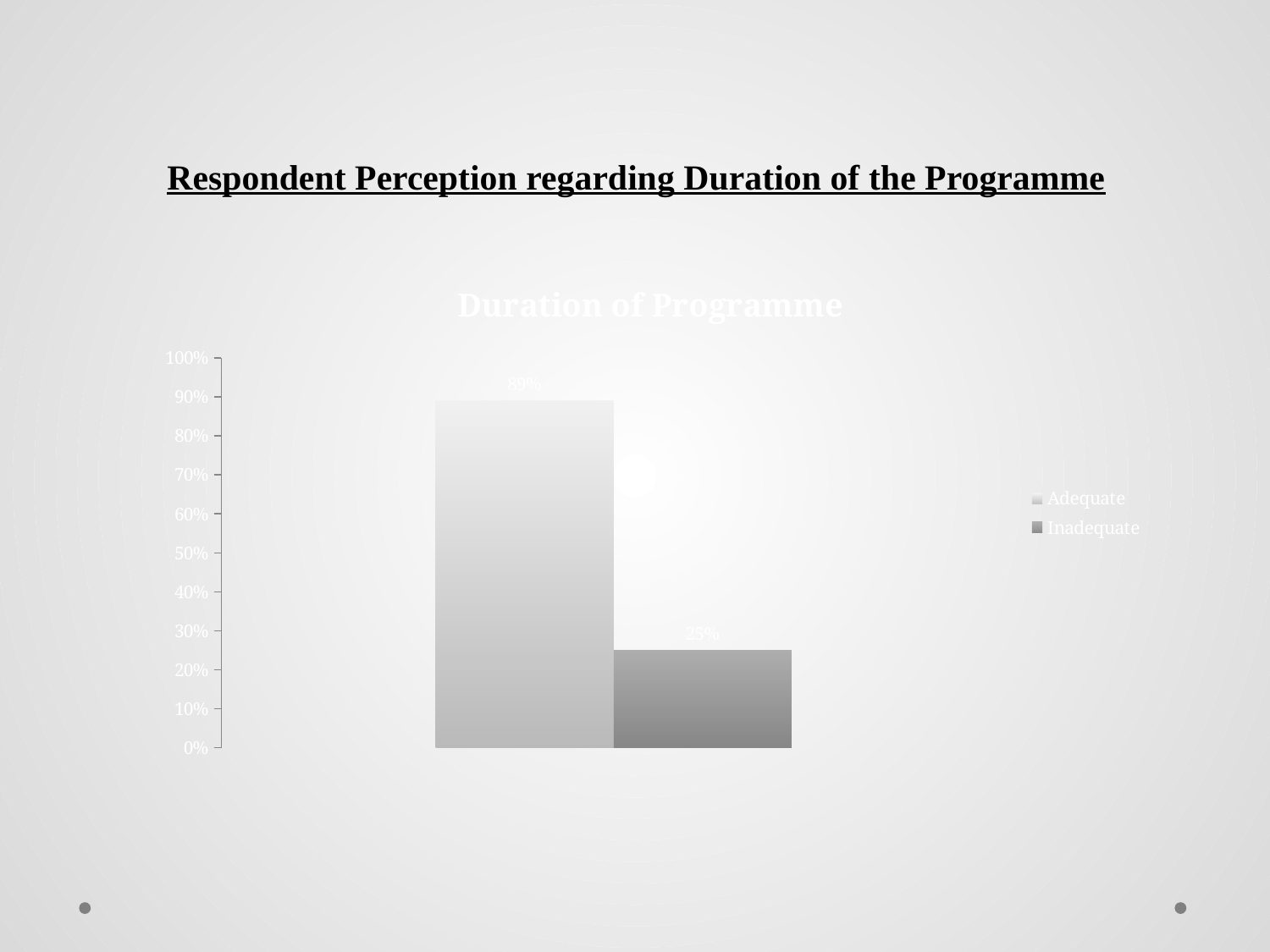
What is the value for Inadequate? 25% How many series does the legend list? 2 What is the title of the chart? Duration of Programme What is the value for Adequate? 89% Is the value for Inadequate greater or less than 30%? less Which series has the lowest value? Inadequate What is the maximum value shown on the vertical axis? 100% Which series has the higher value, Adequate or Inadequate? Adequate What is the difference between the Adequate and Inadequate values? 64% What kind of chart is shown on the slide? bar chart Is the value for Adequate greater or less than 80%? greater Which series has the highest value? Adequate